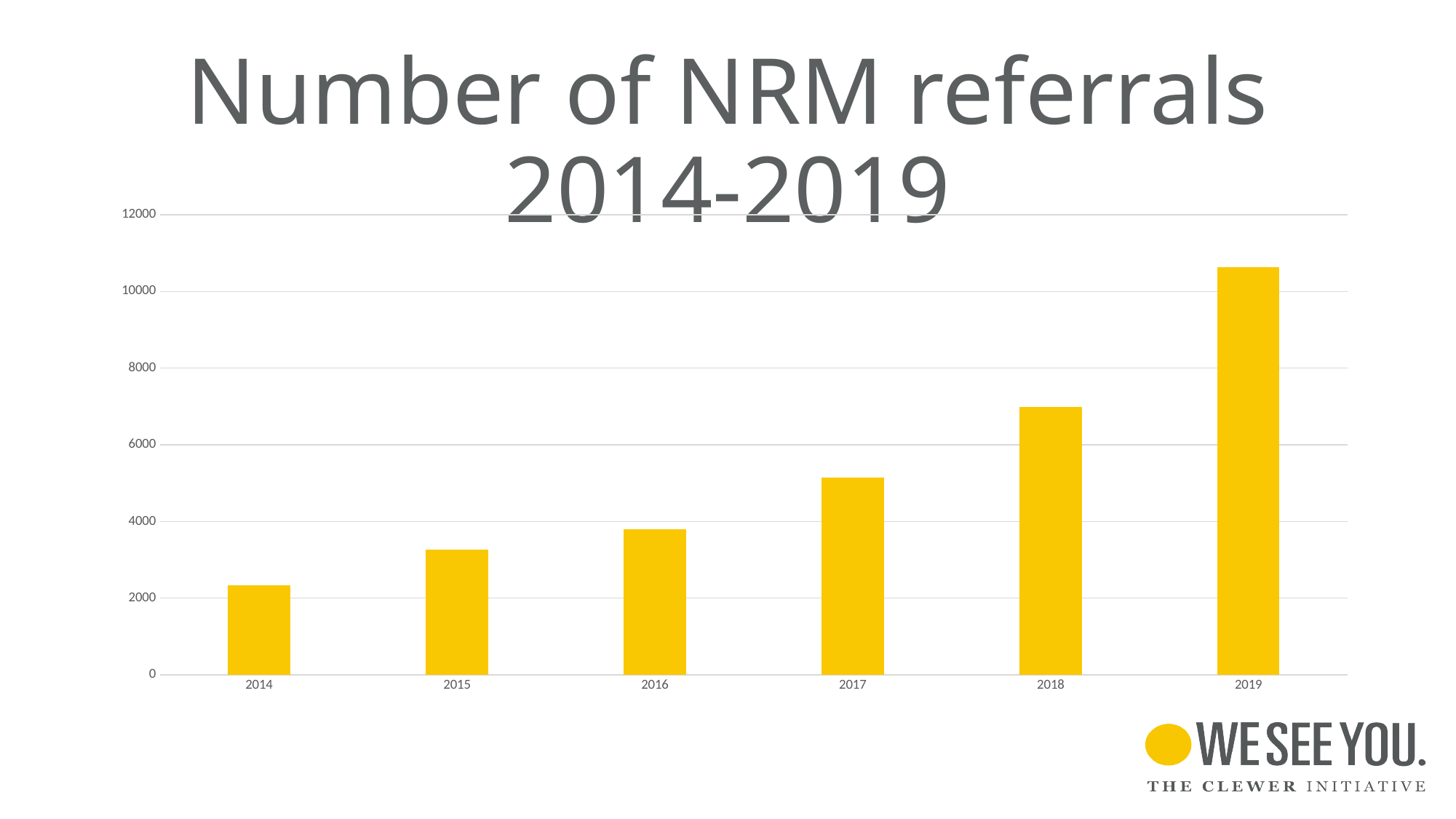
How many years are shown on the x axis of the chart? 6 Which year has more NRM referrals, 2016 or 2018? 2018 What is the title of the chart? Number of NRM referrals 2014-2019 Is the value for 2019 greater or less than 10000? greater Is the value for 2014 greater or less than 2000? greater Do the number of NRM referrals rise or fall from 2014 to 2019? rise Is the value for 2017 greater or less than 4000? greater What type of chart is shown on the slide? bar chart Which year has the lowest number of NRM referrals? 2014 Which year has the highest number of NRM referrals? 2019 What colour are the bars in the chart? yellow